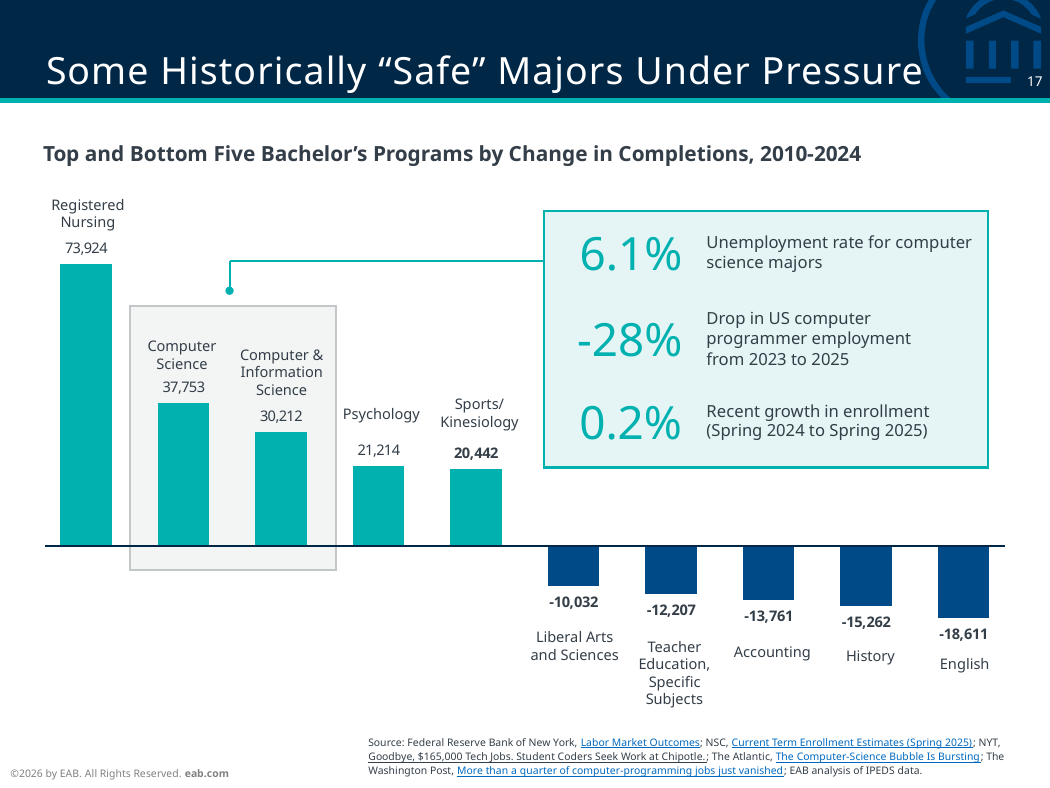
What is the change in completions for English? -18,611 What is the title of the chart? Top and Bottom Five Bachelor's Programs by Change in Completions, 2010-2024 Which program has the highest change in completions? Registered Nursing What is the change in completions for Psychology? 21,214 What is the difference between the change in completions for Computer Science and Computer & Information Science? 7,541 What is the change in completions for Accounting? -13,761 What is the change in completions for Registered Nursing? 73,924 Which has a larger change in completions, Psychology or Sports/Kinesiology? Psychology How many programs are shown in the chart? 10 What kind of chart is shown on the slide? Bar chart Which two programs are highlighted with a grey box in the chart? Computer Science and Computer & Information Science Which program has the lowest change in completions? English